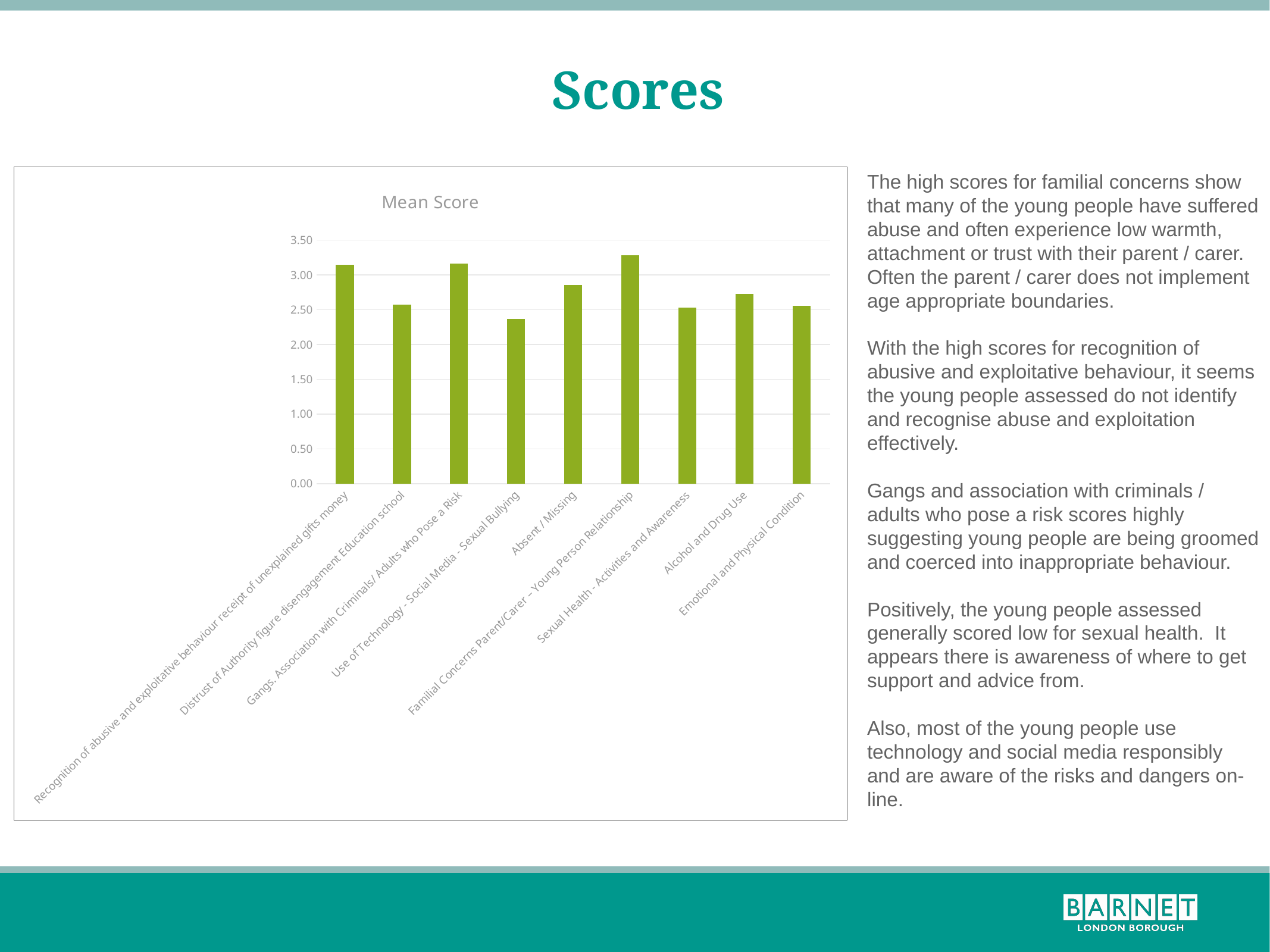
Is the value for Use of Technology - Social Media - Sexual Bullying greater or less than 2.50? less Which category has the highest mean score? Familial Concerns Parent/Carer – Young Person Relationship Is the value for Recognition of abusive and exploitative behaviour receipt of unexplained gifts money greater or less than 3.00? greater What kind of chart is shown on the slide? bar chart Is the value for Absent / Missing greater or less than 2.50? greater Which category has the lowest mean score? Use of Technology - Social Media - Sexual Bullying Which has the larger mean score: Gangs, Association with Criminals/ Adults who Pose a Risk or Distrust of Authority figure disengagement Education school? Gangs, Association with Criminals/ Adults who Pose a Risk How many categories are plotted in the chart? 9 Which has the larger mean score: Absent / Missing or Alcohol and Drug Use? Absent / Missing What is the title of the chart? Mean Score